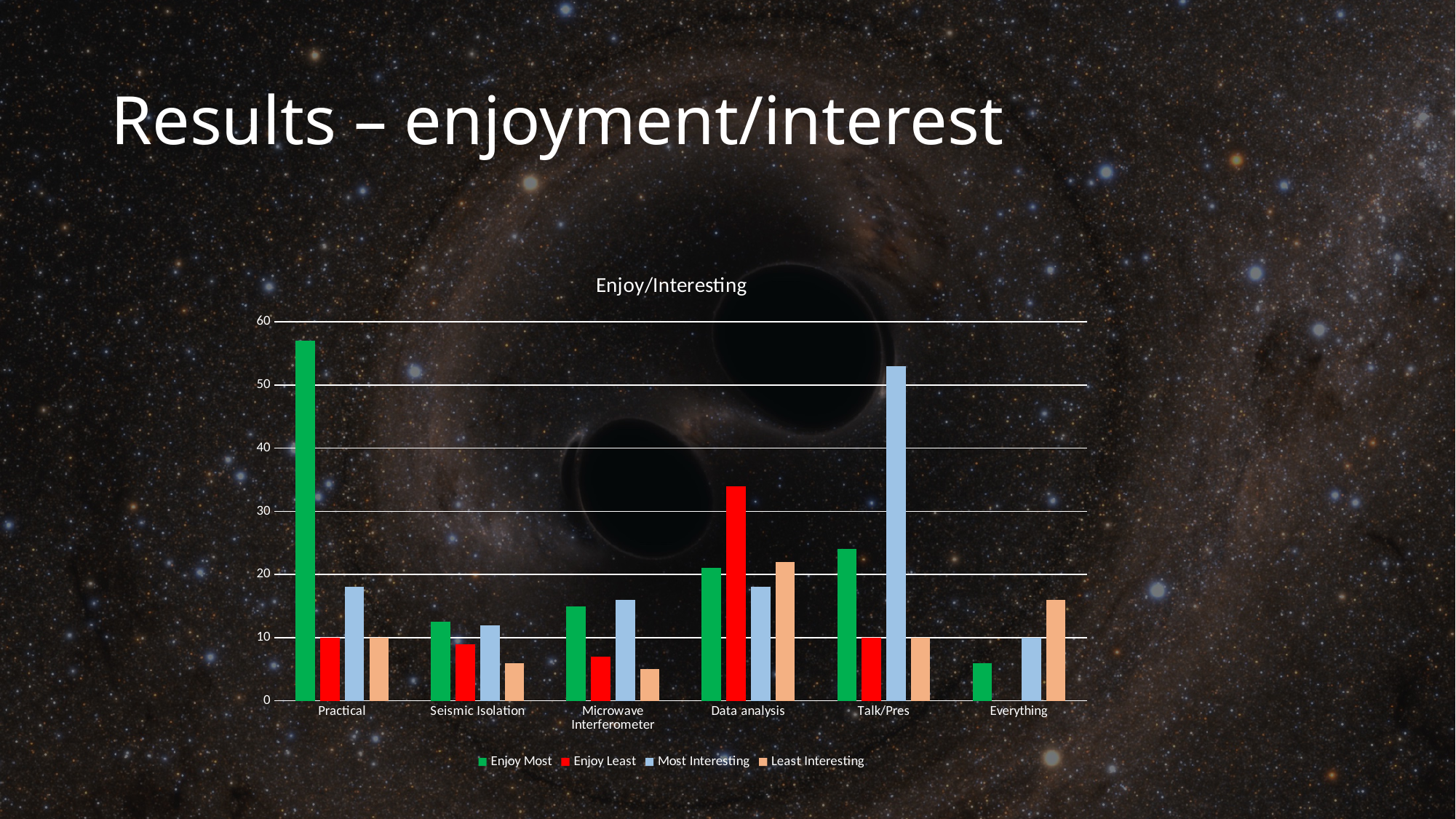
Is the Enjoy Most value for Practical greater or less than 50? greater What kind of chart is shown on the slide? bar chart Which category has the highest Enjoy Least value? Data analysis Which category has the highest Enjoy Most value? Practical Is the Least Interesting value for Seismic Isolation greater or less than 10? less Which category has the lowest Enjoy Most value? Everything What is the title of the chart? Enjoy/Interesting Is the Enjoy Least value for Data analysis greater or less than 30? greater How many series does the legend list? 4 How many categories are shown on the x axis? 6 Which is larger, the Enjoy Least value for Data analysis or the Enjoy Least value for Talk/Pres? Data analysis Which category has the highest Most Interesting value? Talk/Pres